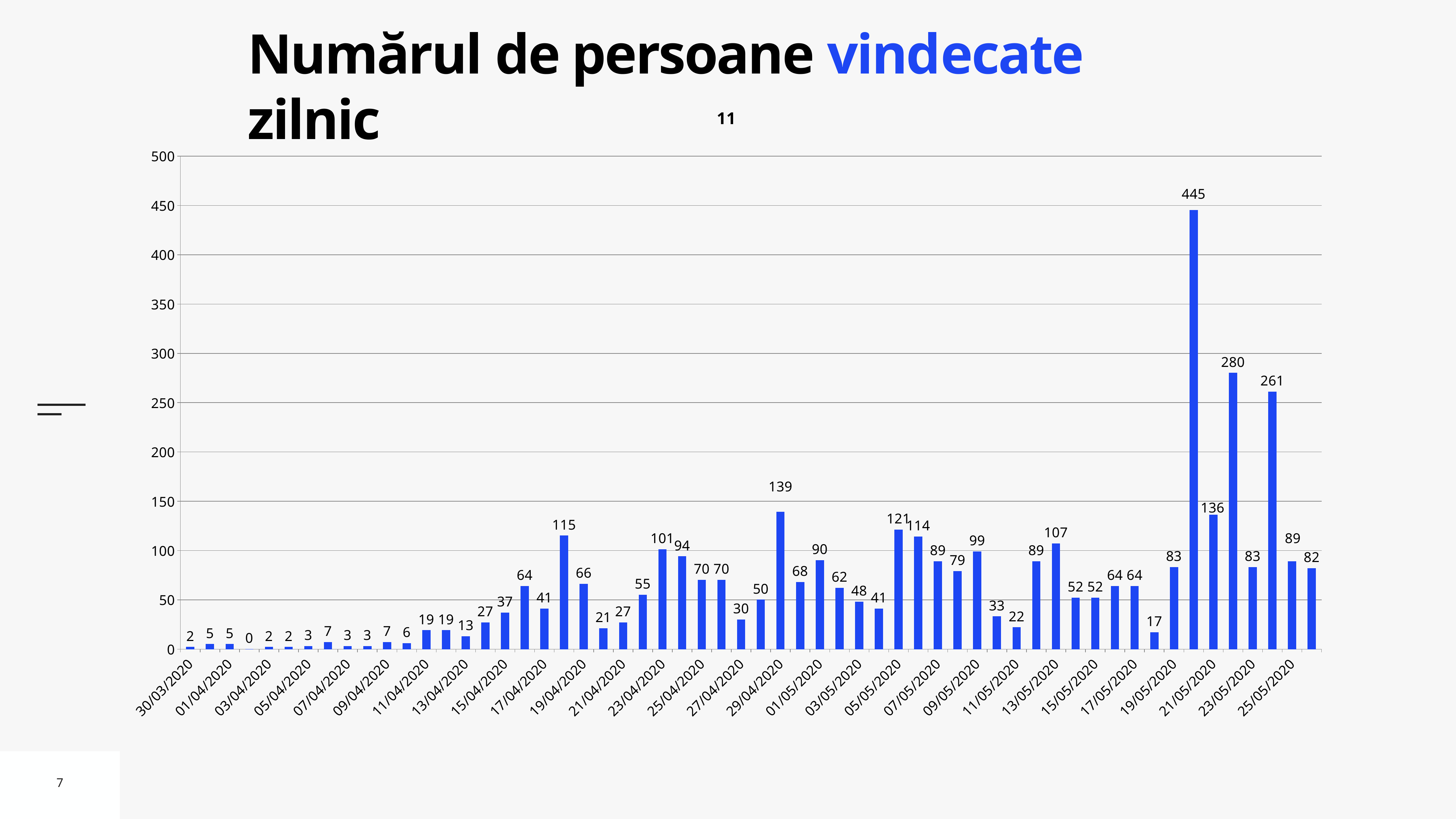
What is the value for 30/03/2020? 2 What is the value for 23/04/2020? 101 What kind of chart is shown on the slide? bar chart What is the value for 29/04/2020? 139 What is the highest value shown in the chart? 445 What is the value for 05/05/2020? 121 What is the title of the slide? Numărul de persoane vindecate zilnic What is the difference between the values for 29/04/2020 and 01/05/2020? 49 What is the lowest value shown in the chart? 0 What is the value for 13/05/2020? 107 Which is larger, the value for 21/05/2020 or the value for 25/05/2020? 21/05/2020 Is the highest bar in the chart greater or less than 400? greater